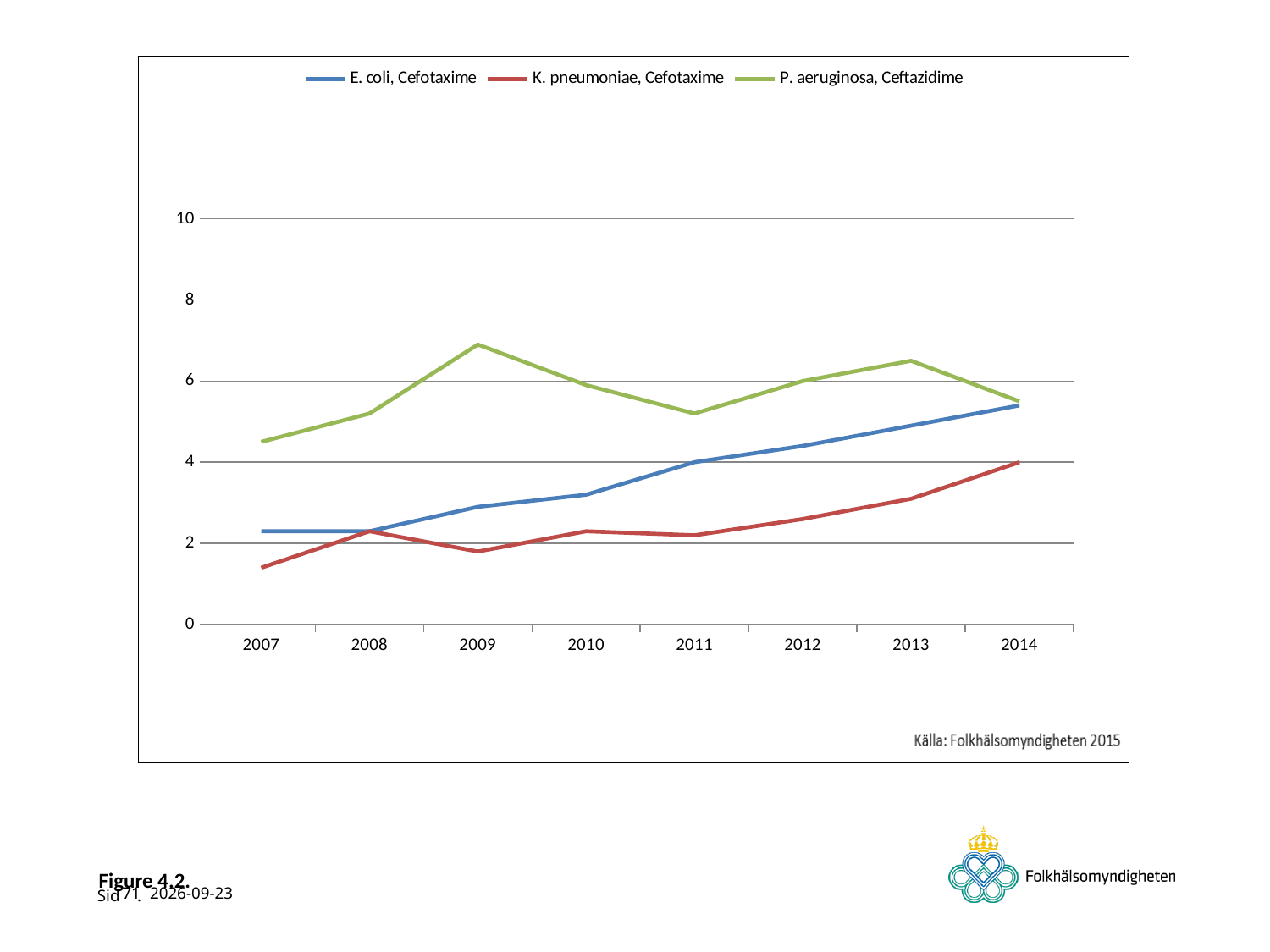
Is the value for P. aeruginosa, Ceftazidime in 2009 greater or less than 6? greater Does the E. coli, Cefotaxime line generally rise or fall from 2007 to 2014? rise What kind of chart is shown on the slide? line chart How many series does the legend list? 3 Is the value for K. pneumoniae, Cefotaxime in 2009 greater or less than 2? less What colour is the line for P. aeruginosa, Ceftazidime? green Is the value for P. aeruginosa, Ceftazidime in 2007 greater or less than 4? greater How many years are shown on the x axis? 8 Which series has the highest value in 2009? P. aeruginosa, Ceftazidime Which series has the lowest value in 2007? K. pneumoniae, Cefotaxime Which is larger in 2013, the value for E. coli, Cefotaxime or the value for K. pneumoniae, Cefotaxime? E. coli, Cefotaxime